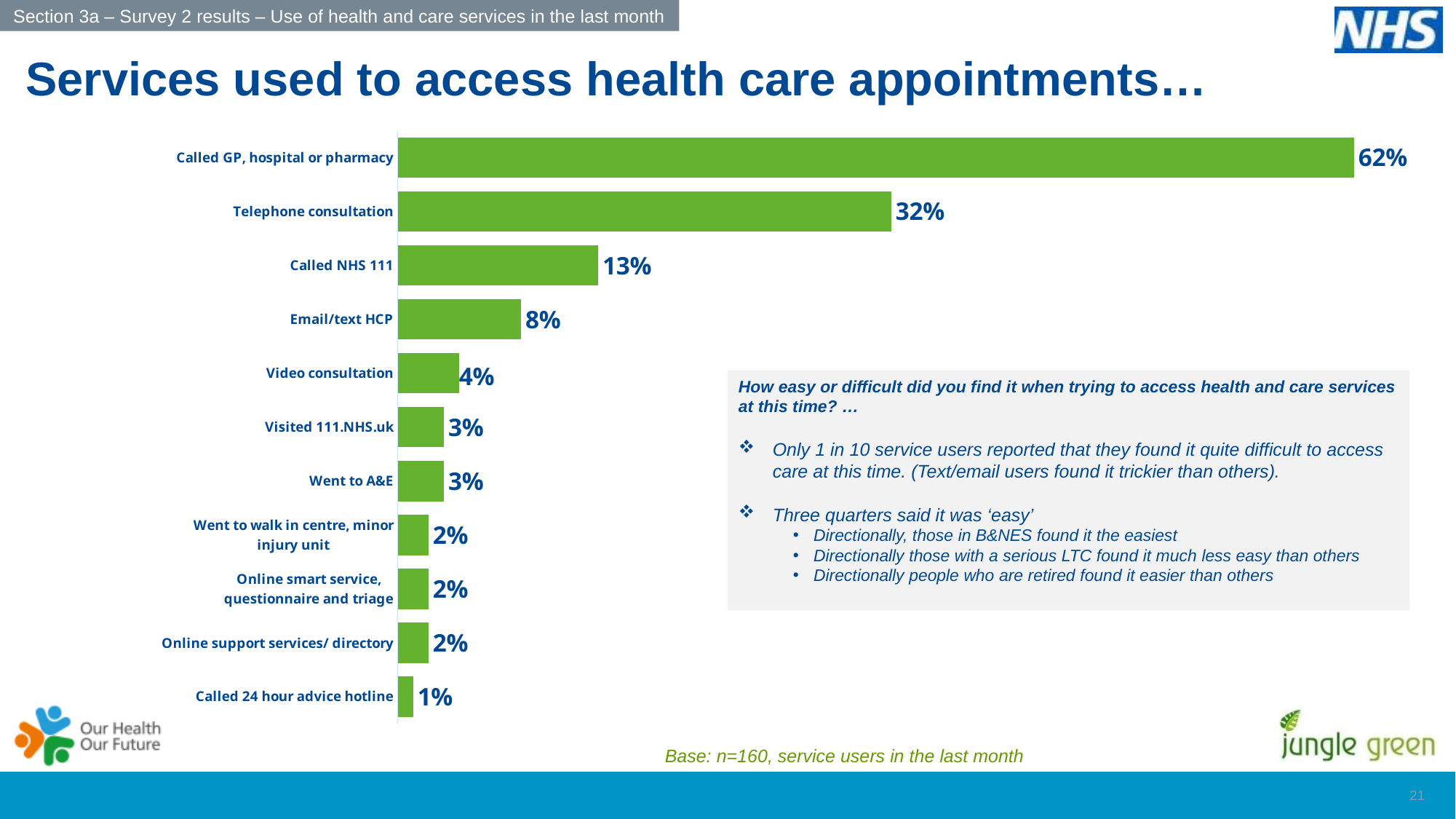
What is the difference in percentage points between Called NHS 111 and Email/text HCP? 5 Which service has the highest percentage of use? Called GP, hospital or pharmacy How many services (categories) are shown in the chart? 11 What percentage of service users called NHS 111? 13% What kind of chart is used on this slide? Bar chart Which is larger, the value for Email/text HCP or the value for Video consultation? Email/text HCP What is the difference in percentage points between Called GP, hospital or pharmacy and Telephone consultation? 30 Which service has the lowest percentage of use? Called 24 hour advice hotline What percentage of service users called their GP, hospital or pharmacy? 62% What is the value shown for Video consultation? 4% What is the value shown for Telephone consultation? 32% What percentage of service users called the 24 hour advice hotline? 1%